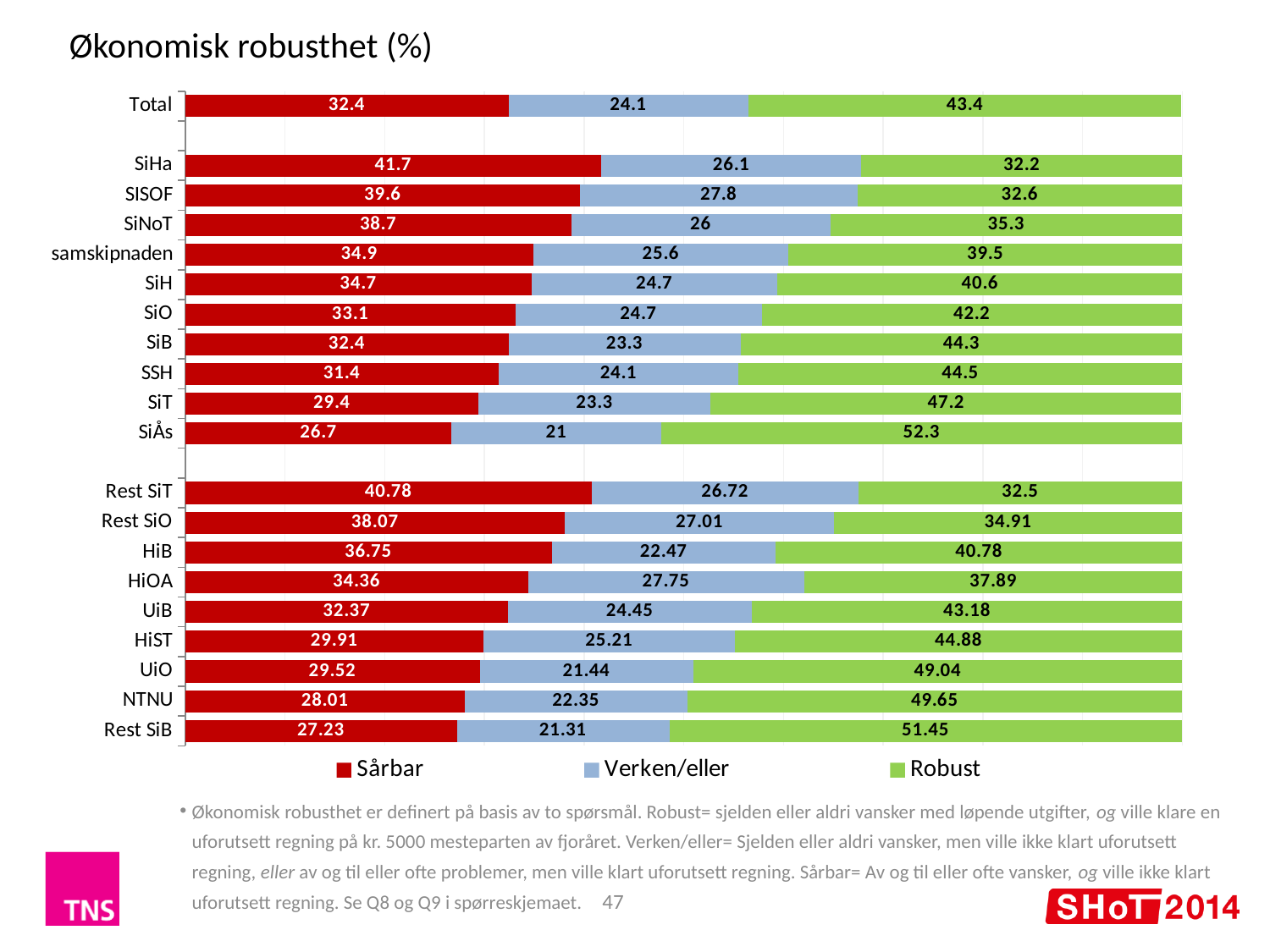
Which category has the lowest Sårbar value? SiÅs How many series does the legend list? 3 How many categories are shown on the chart? 20 Which has a larger Robust value, SiT or UiO? UiO What is the Sårbar value for SiHa? 41.7 What is the Verken/eller value for HiOA? 27.75 What kind of chart is shown on the slide? Stacked bar chart What is the difference between the Robust and Sårbar values for NTNU? 21.64 What is the Robust value for SiÅs? 52.3 Which category has the highest Robust value? SiÅs Which category has the highest Sårbar value? SiHa What is the total of the stacked bar for SiÅs? 100